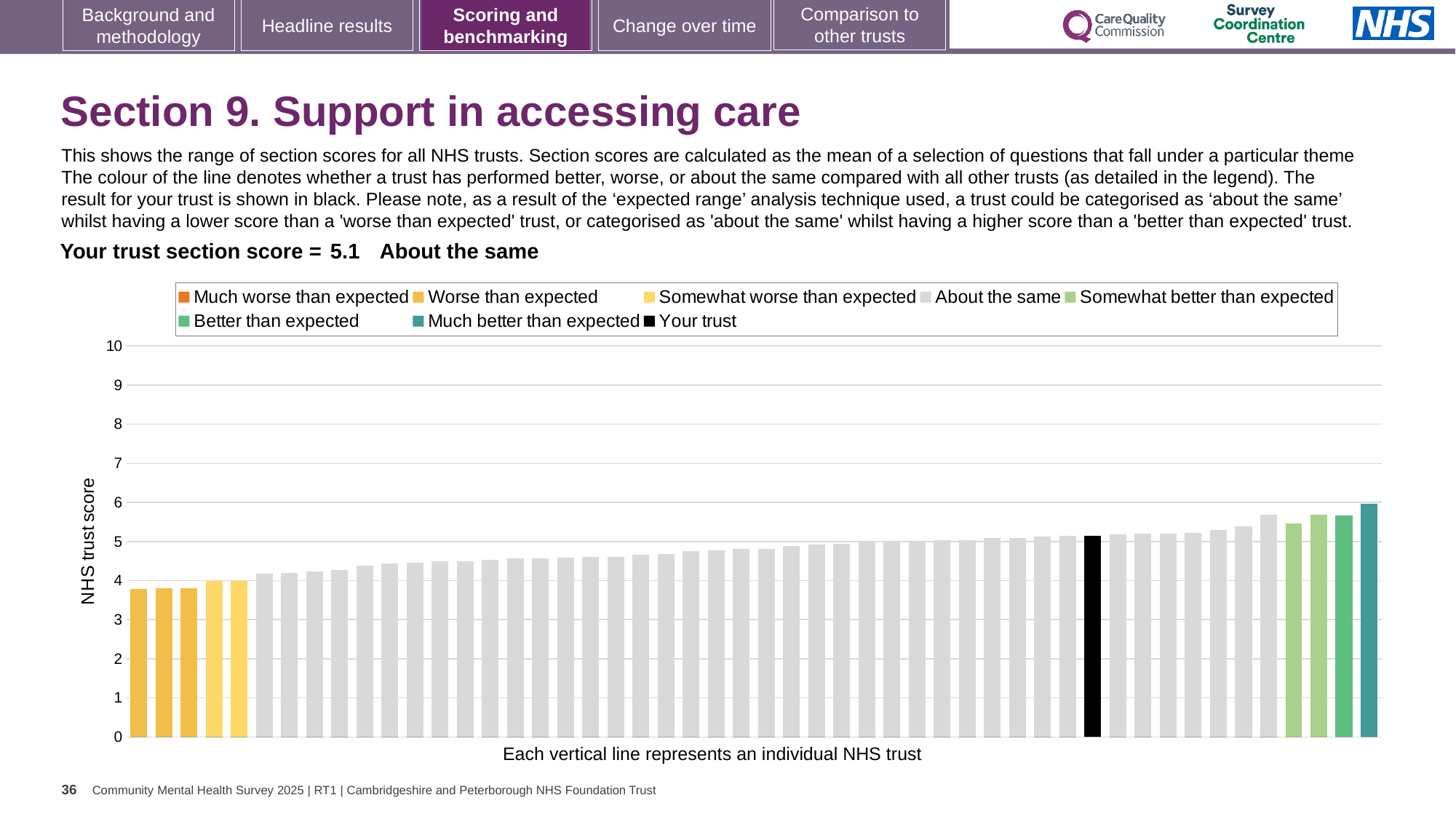
How is your trust's section score categorised compared with other trusts? About the same How many bars are coloured in the 'Worse than expected' gold colour? 3 Is the value of the lowest bar greater or less than 4? less What kind of chart is shown on the slide? bar chart Is the value of the black bar (your trust) greater or less than 4? greater What is the label on the vertical axis of the chart? NHS trust score What colour is the bar representing your trust? black What is the section score for your trust shown on the slide? 5.1 Is the value of the highest bar greater or less than 5? greater How many entries does the chart legend list? 8 How many bars are coloured teal (Much better than expected)? 1 Do the bar values rise or fall from left to right along the x axis? rise